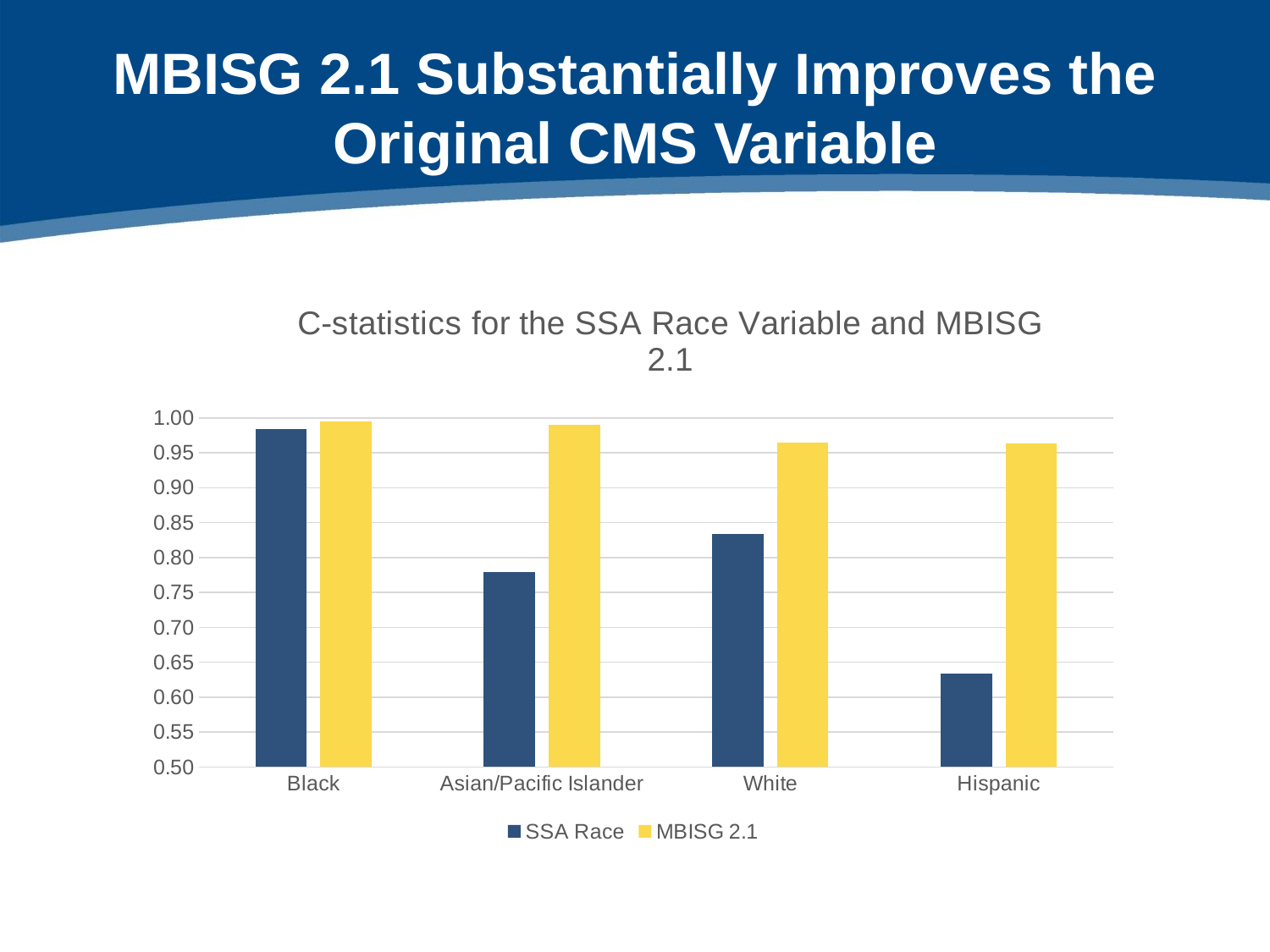
How many series does the legend list? 2 Is the SSA Race value for Asian/Pacific Islander greater or less than 0.75? greater Is the SSA Race value for White greater or less than 0.80? greater What kind of chart is shown on the slide? bar chart Which category has the highest SSA Race value? Black What is the title of the chart? C-statistics for the SSA Race Variable and MBISG 2.1 Which is larger for the SSA Race series: the value for White or the value for Asian/Pacific Islander? White How many race/ethnicity categories are shown on the x axis? 4 Is the MBISG 2.1 value for Hispanic greater or less than 0.90? greater For Hispanic, which series has the larger value: SSA Race or MBISG 2.1? MBISG 2.1 Which category has the lowest SSA Race value? Hispanic